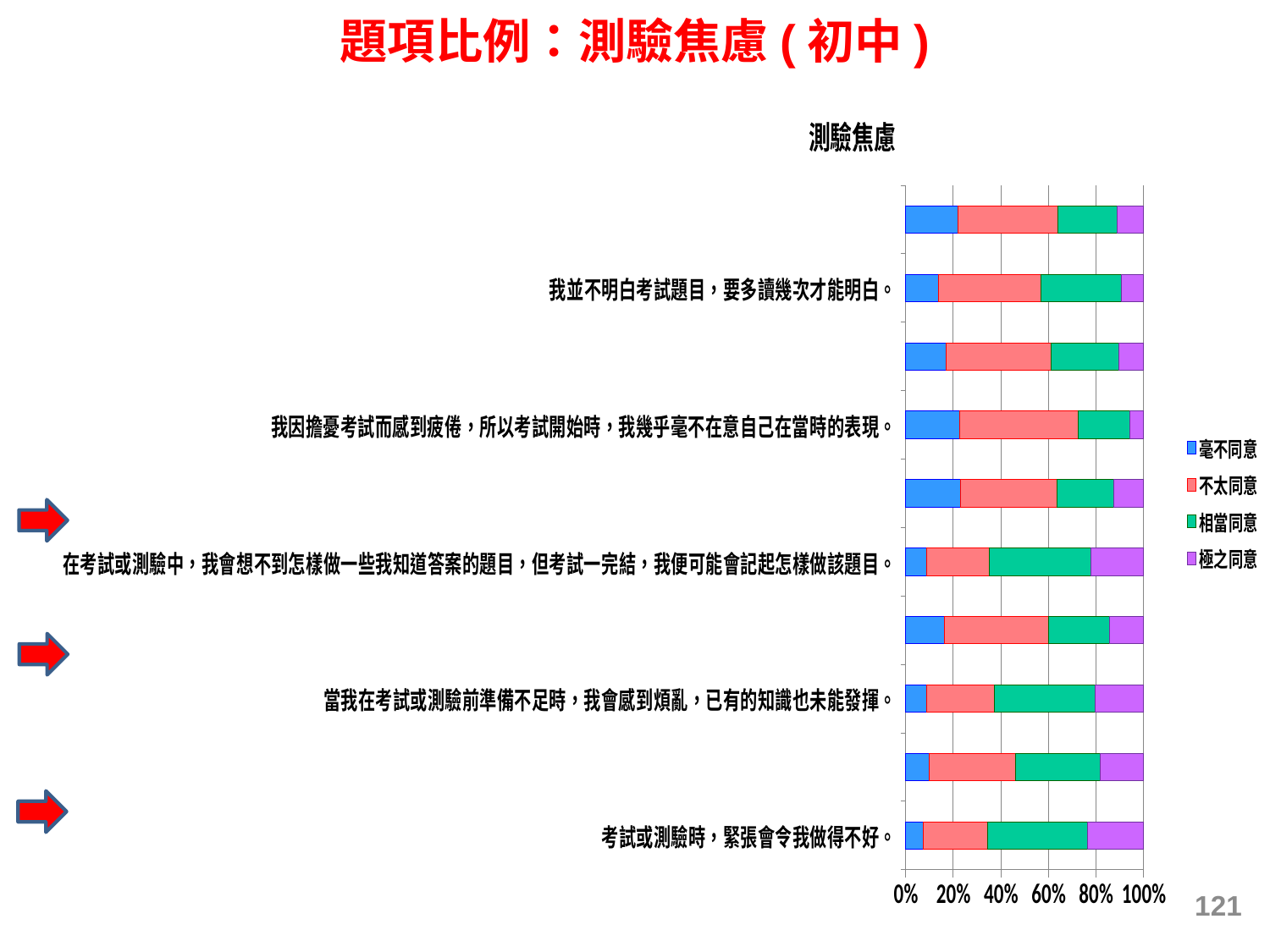
What is the title of the chart? 測驗焦慮 What kind of chart is shown on the slide? stacked bar chart Is the 極之同意 segment for "我因擔憂考試而感到疲倦，所以考試開始時，我幾乎毫不在意自己在當時的表現。" greater or less than 20%? less How many series does the legend of the 測驗焦慮 chart list? 4 Is the 不太同意 segment for "我因擔憂考試而感到疲倦，所以考試開始時，我幾乎毫不在意自己在當時的表現。" greater or less than 40%? greater Which has the larger 毫不同意 segment: "我因擔憂考試而感到疲倦，所以考試開始時，我幾乎毫不在意自己在當時的表現。" or "考試或測驗時，緊張會令我做得不好。"? 我因擔憂考試而感到疲倦，所以考試開始時，我幾乎毫不在意自己在當時的表現。 Is the 毫不同意 segment for "我並不明白考試題目，要多讀幾次才能明白。" greater or less than 20%? less Among the labelled items, which has the largest 毫不同意 segment? 我因擔憂考試而感到疲倦，所以考試開始時，我幾乎毫不在意自己在當時的表現。 How many bars are plotted in the 測驗焦慮 chart? 10 Which colour represents 相當同意 in the legend? green